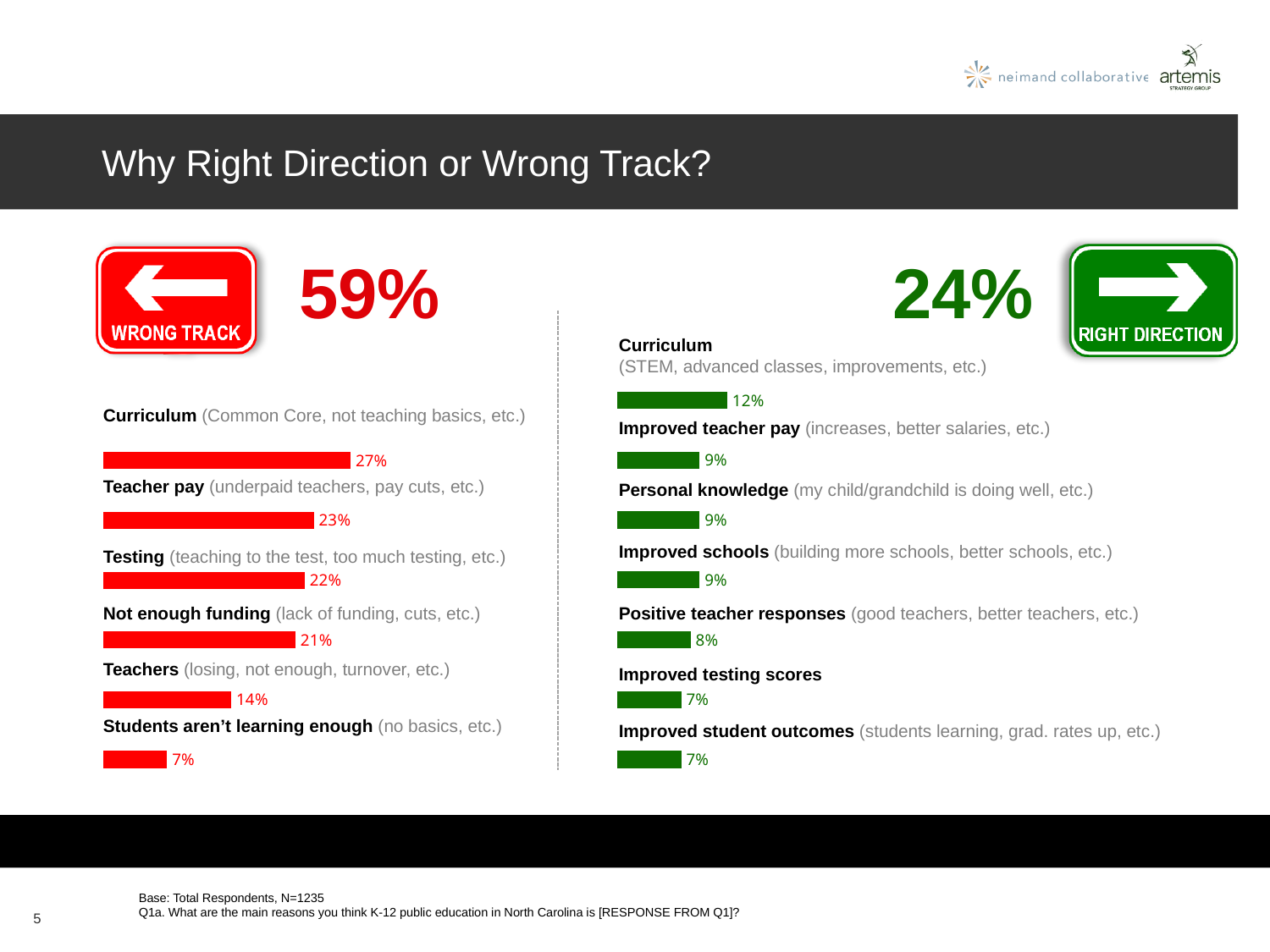
In the Wrong Track chart on the left, what percentage is shown for Curriculum? 27% What type of chart is used on the left side of the slide to show the Wrong Track reasons? Bar chart In the Wrong Track chart on the left, which reason has the highest percentage? Curriculum In the Wrong Track chart on the left, which is larger: Testing or Not enough funding? Testing How many reasons are listed in the Wrong Track chart on the left? 6 How many reasons are listed in the Right Direction chart on the right? 7 In the Wrong Track chart on the left, what percentage is shown for Teacher pay? 23% In the Right Direction chart on the right, which reason has the highest percentage? Curriculum In the Right Direction chart on the right, what percentage is shown for Positive teacher responses? 8% In the Wrong Track chart on the left, which reason has the lowest percentage? Students aren't learning enough In the Wrong Track chart on the left, what is the difference between the percentages for Curriculum and Teachers? 13% In the Right Direction chart on the right, what percentage is shown for Curriculum? 12%